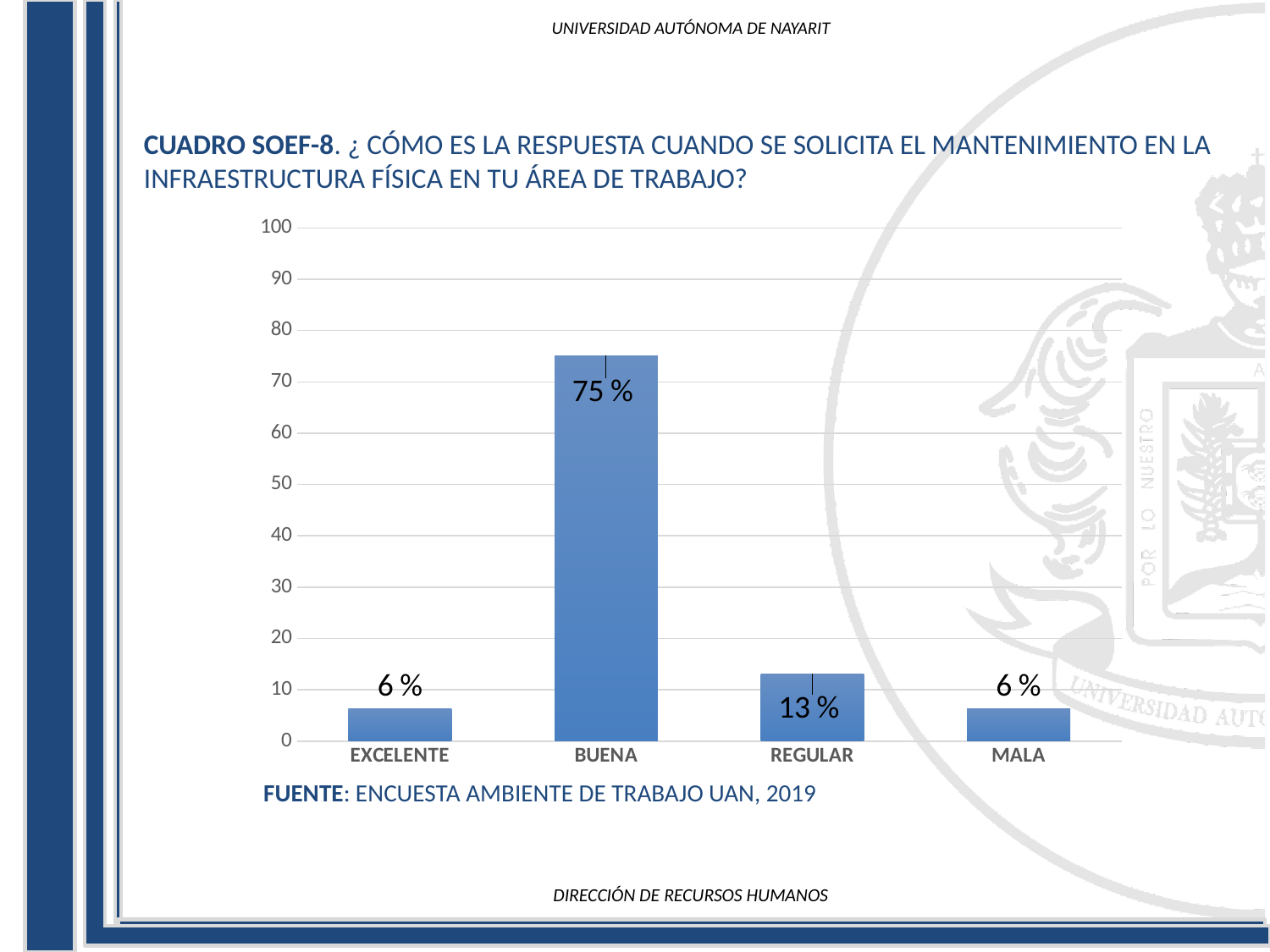
Is the value for MALA greater or less than 10? less What is the value for EXCELENTE? 6 % How many categories are shown on the x axis? 4 What is the highest value shown on the y axis? 100 What is the source cited below the chart? ENCUESTA AMBIENTE DE TRABAJO UAN, 2019 Is the value for BUENA greater or less than 70? greater Which is larger, the value for REGULAR or the value for MALA? REGULAR What is the value for BUENA? 75 % What kind of chart is shown on the slide? bar chart What is the value for REGULAR? 13 % What is the difference between the values for BUENA and REGULAR? 62 % Which category has the highest value? BUENA